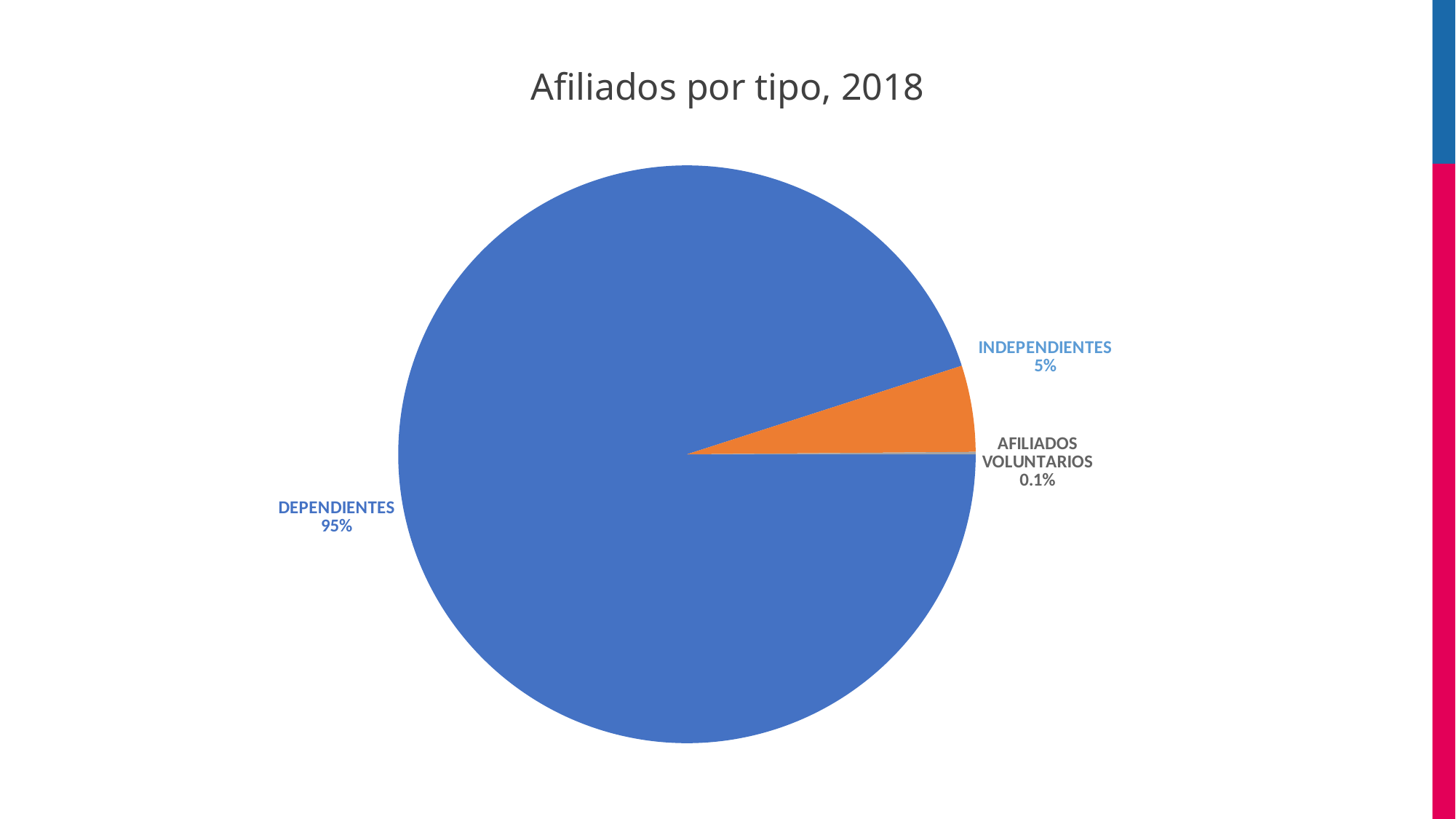
How many slices does the pie chart have? 3 What is the title of the chart? Afiliados por tipo, 2018 Which category has the largest slice? DEPENDIENTES Which category has the smallest slice? AFILIADOS VOLUNTARIOS What share of the pie is DEPENDIENTES? 95% What share of the pie is INDEPENDIENTES? 5% Which is larger, INDEPENDIENTES or AFILIADOS VOLUNTARIOS? INDEPENDIENTES What kind of chart is shown on the slide? pie chart What share of the pie is AFILIADOS VOLUNTARIOS? 0.1% What is the difference between the DEPENDIENTES share and the INDEPENDIENTES share? 90% What colour is the INDEPENDIENTES slice? orange